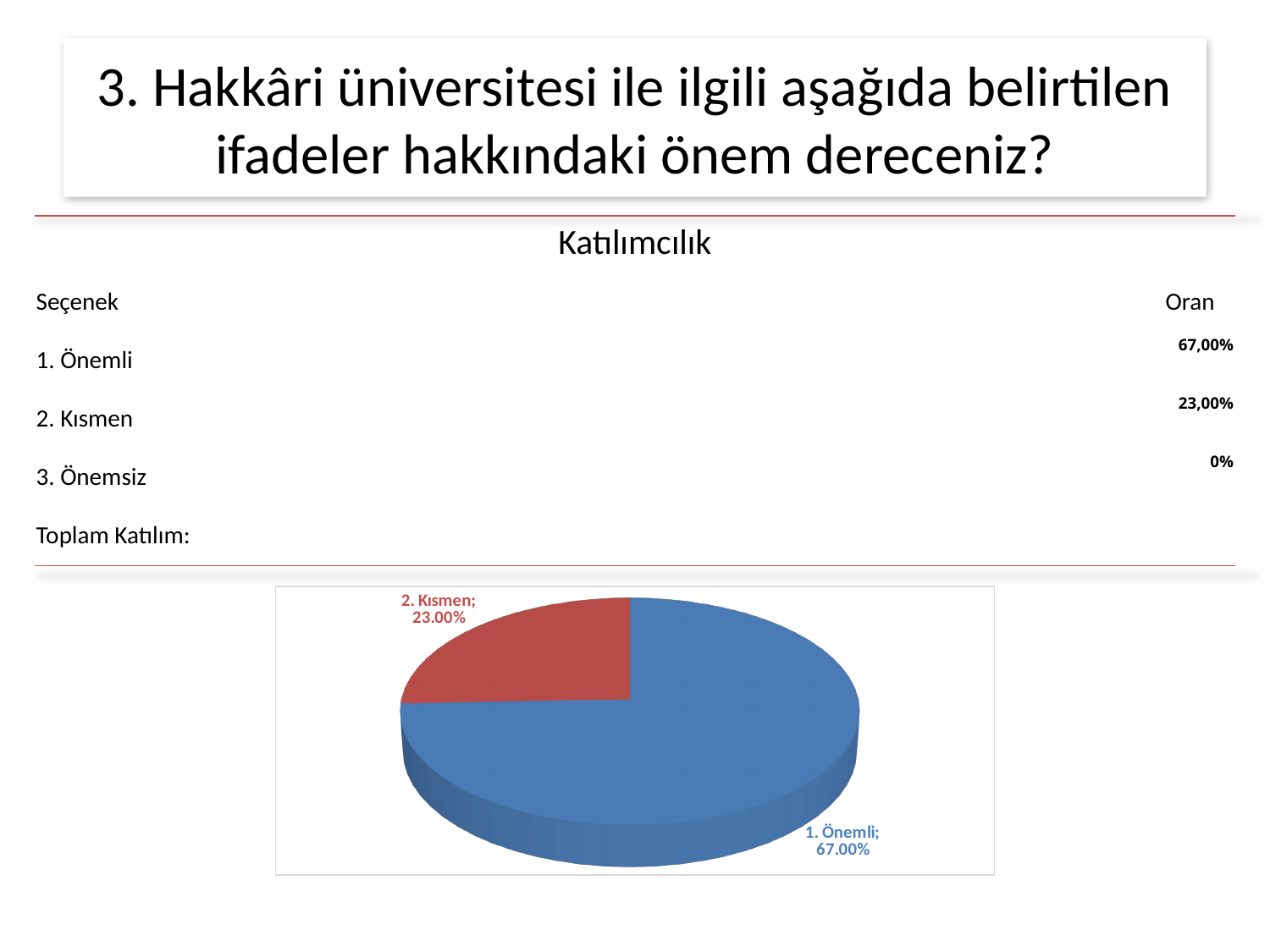
What is the value shown for the "2. Kısmen" slice in the pie chart? 23.00% What colour is the "1. Önemli" slice in the pie chart? blue What is the value shown for the "1. Önemli" slice in the pie chart? 67.00% According to the table above the chart, what is the Oran value for "3. Önemsiz"? 0% How many labelled slices does the pie chart show? 2 Which slice of the pie chart is the largest? 1. Önemli Which labelled slice of the pie chart is the smallest? 2. Kısmen What colour is the "2. Kısmen" slice in the pie chart? red Which is larger in the pie chart, "1. Önemli" or "2. Kısmen"? 1. Önemli What is the difference between the "1. Önemli" and "2. Kısmen" values in the pie chart? 44.00% What kind of chart is shown on the slide? pie chart